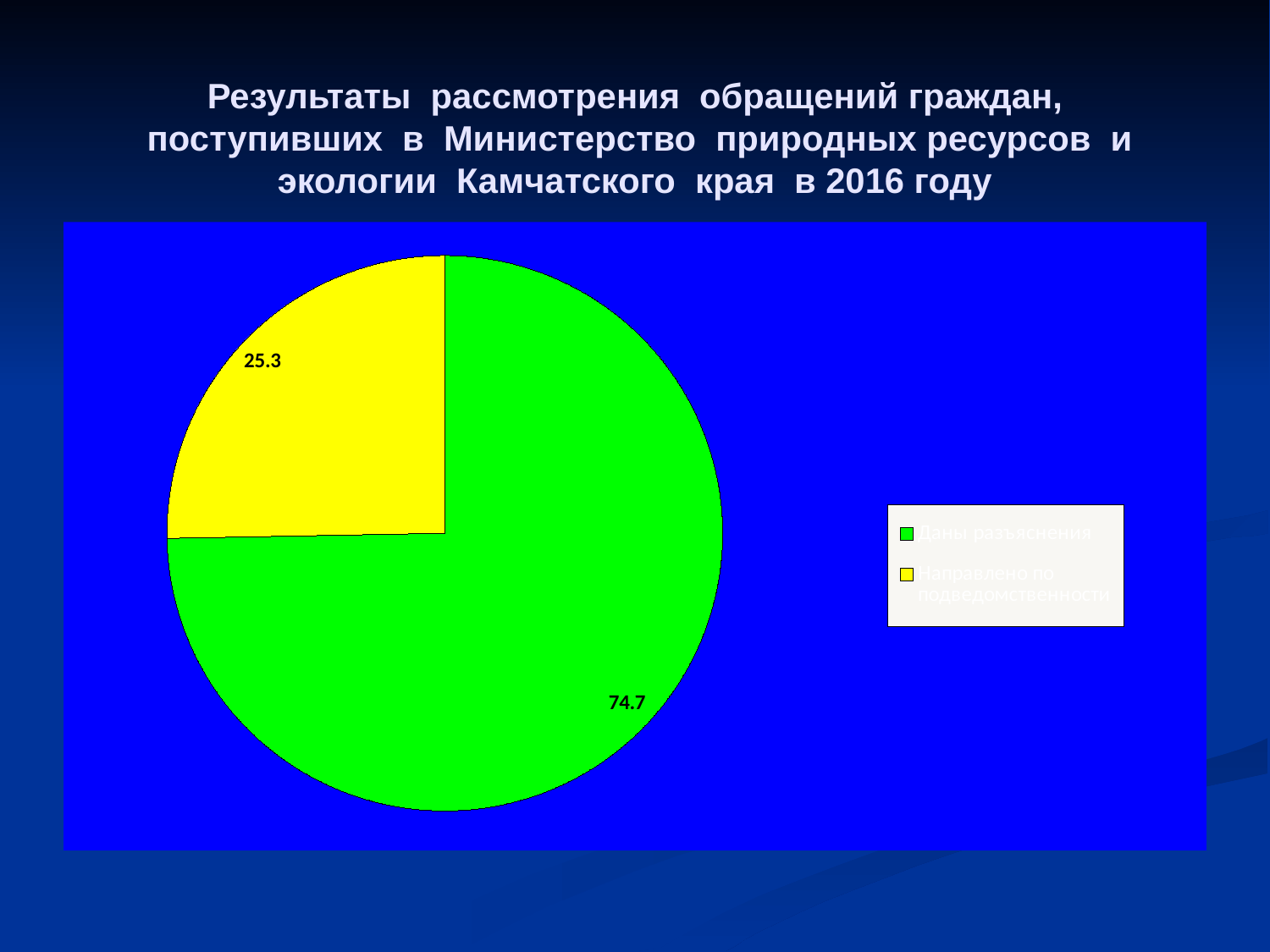
What is the value shown for the green slice (Даны разъяснения)? 74.7 Which category has the smallest slice of the pie? Направлено по подведомственности How many slices does the pie chart have? 2 What kind of chart is shown on the slide? pie chart What is the value shown for the yellow slice (Направлено по подведомственности)? 25.3 Which is larger: the slice for Даны разъяснения or the slice for Направлено по подведомственности? Даны разъяснения What colour is the slice for Даны разъяснения? green How many entries does the legend list? 2 What colour is the slice for Направлено по подведомственности? yellow Which category has the largest slice of the pie? Даны разъяснения What is the difference between the values of the two slices? 49.4